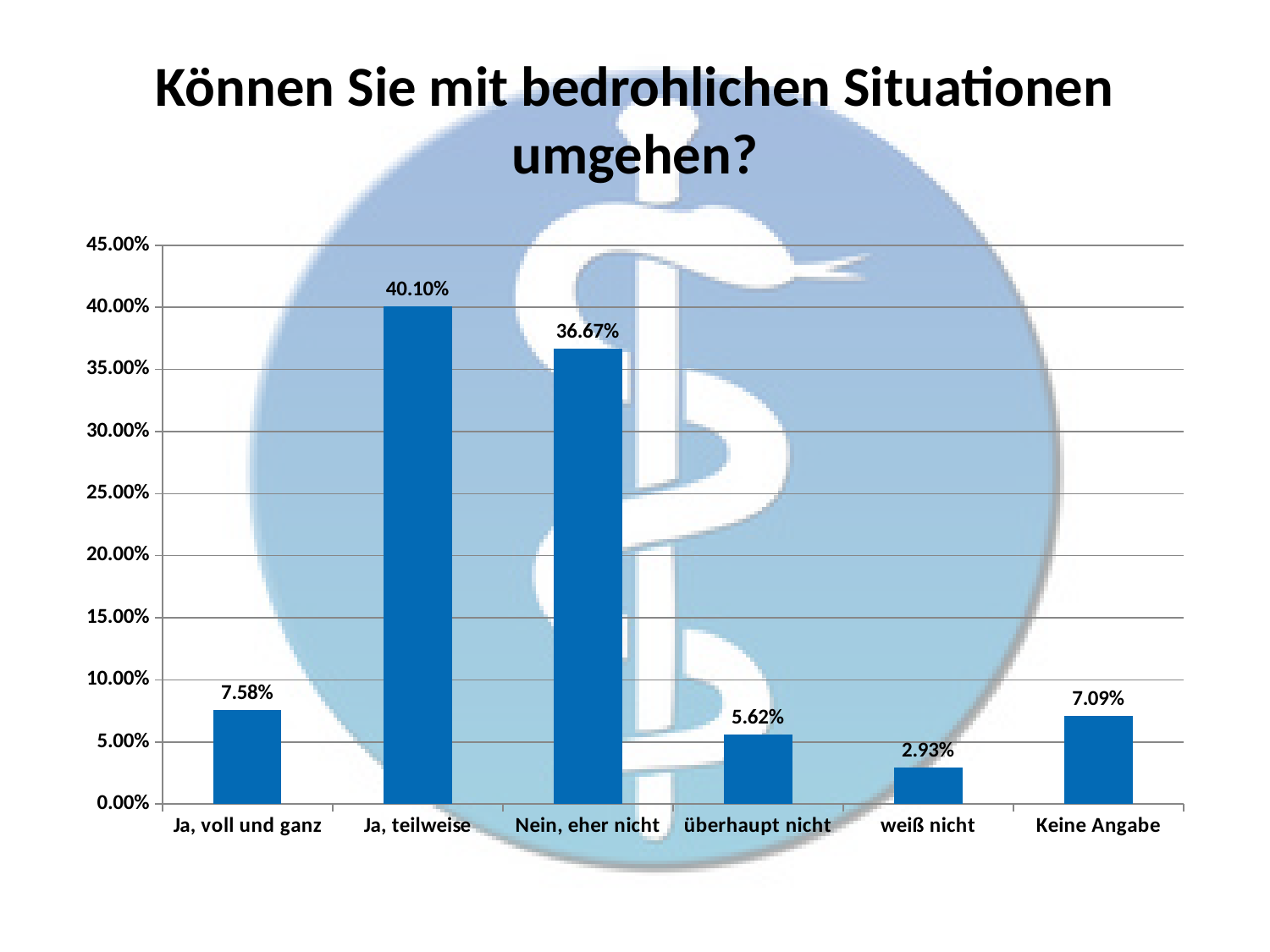
Is the value for "Nein, eher nicht" greater or less than 35.00%? greater What kind of chart is shown on the slide? bar chart What is the difference between the values for "Ja, voll und ganz" and "Keine Angabe"? 0.49% What is the title of the slide? Können Sie mit bedrohlichen Situationen umgehen? Which category has the highest value? Ja, teilweise What is the value for "Ja, teilweise"? 40.10% What is the value for "Keine Angabe"? 7.09% Which is larger, the value for "überhaupt nicht" or the value for "weiß nicht"? überhaupt nicht What is the difference between the values for "Ja, teilweise" and "Nein, eher nicht"? 3.43% Which category has the lowest value? weiß nicht How many categories are shown on the x axis? 6 What is the value for "weiß nicht"? 2.93%